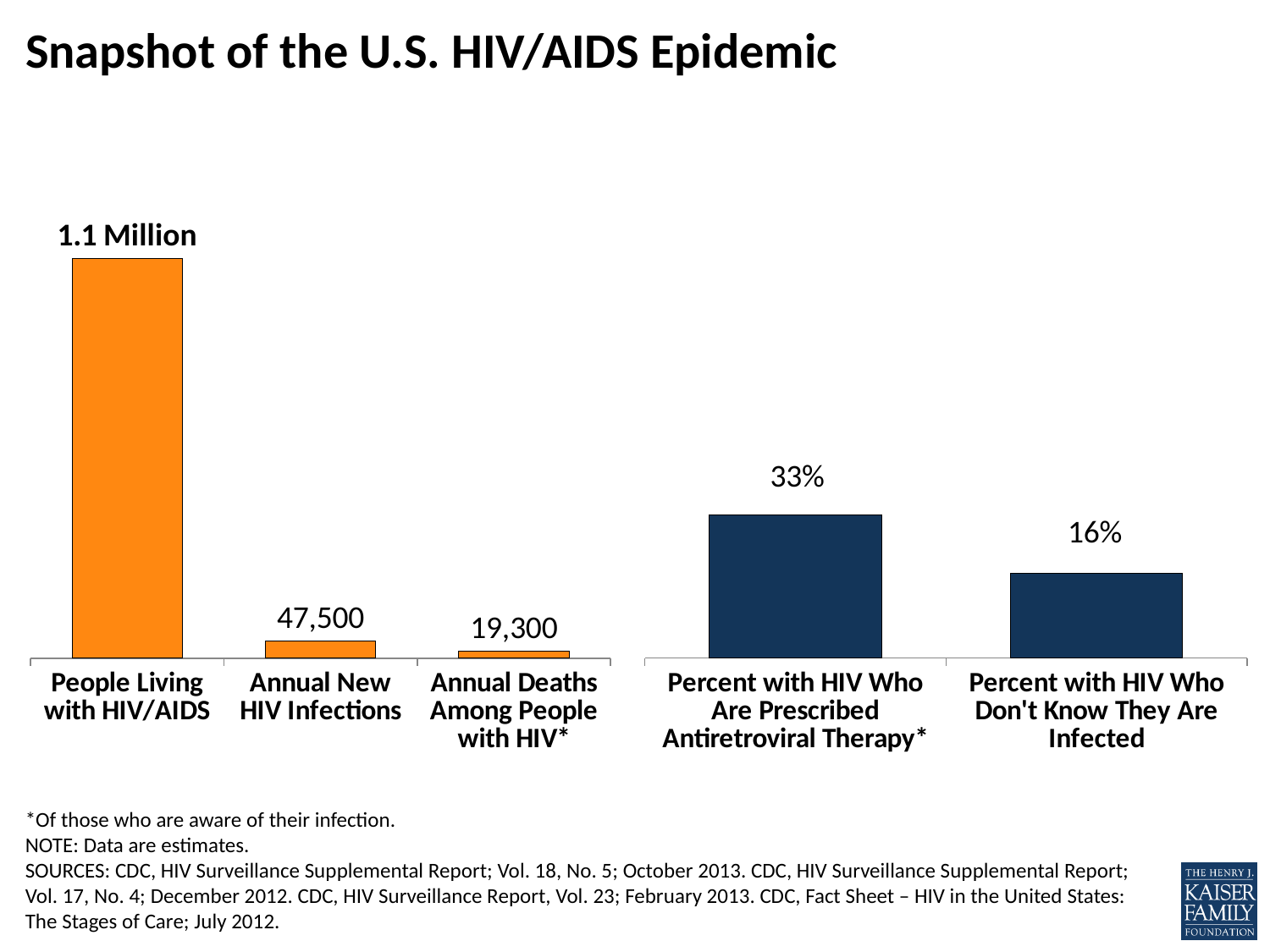
On the left chart, which category has the highest value? People Living with HIV/AIDS On the left chart, what is the value for People Living with HIV/AIDS? 1.1 Million On the right chart, what is the value for Percent with HIV Who Don't Know They Are Infected? 16% On the left chart, which category has the lowest value? Annual Deaths Among People with HIV On the left chart, what is the difference between Annual New HIV Infections and Annual Deaths Among People with HIV? 28,200 On the left chart, what is the value for Annual New HIV Infections? 47,500 On the left chart, what is the value for Annual Deaths Among People with HIV? 19,300 What kind of chart is the right chart? Bar chart On the right chart, what is the difference between the percent prescribed antiretroviral therapy and the percent who don't know they are infected? 17 percentage points How many categories are shown on the left chart? 3 On the right chart, which is larger: Percent with HIV Who Are Prescribed Antiretroviral Therapy or Percent with HIV Who Don't Know They Are Infected? Percent with HIV Who Are Prescribed Antiretroviral Therapy On the right chart, what is the value for Percent with HIV Who Are Prescribed Antiretroviral Therapy? 33%